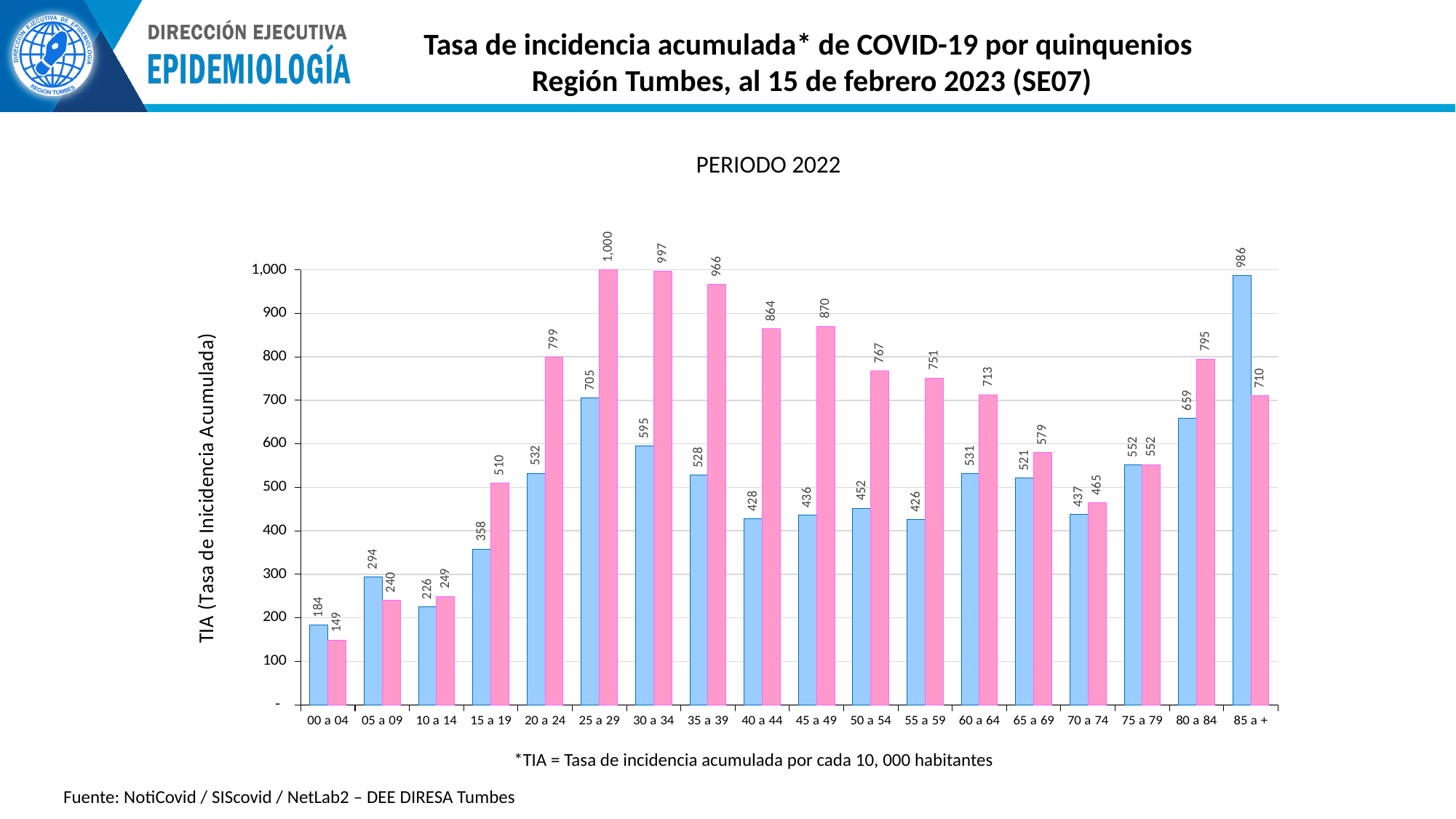
How many age groups are shown on the x axis? 18 Which is larger for the 85 a + age group, the blue bar or the pink bar? the blue bar What kind of chart is shown on the slide? bar chart Which age group has the highest pink bar? 25 a 29 What is the difference between the pink and blue bars for the 20 a 24 age group? 267 Which age group has the lowest pink bar? 00 a 04 What is the value of the blue bar for the 85 a + age group? 986 Which age group has the lowest blue bar? 00 a 04 What is the value of the blue bar for the 40 a 44 age group? 428 What is the value of the pink bar for the 25 a 29 age group? 1,000 What is the title shown above the chart? PERIODO 2022 What is the label of the y axis? TIA (Tasa de Incidencia Acumulada)